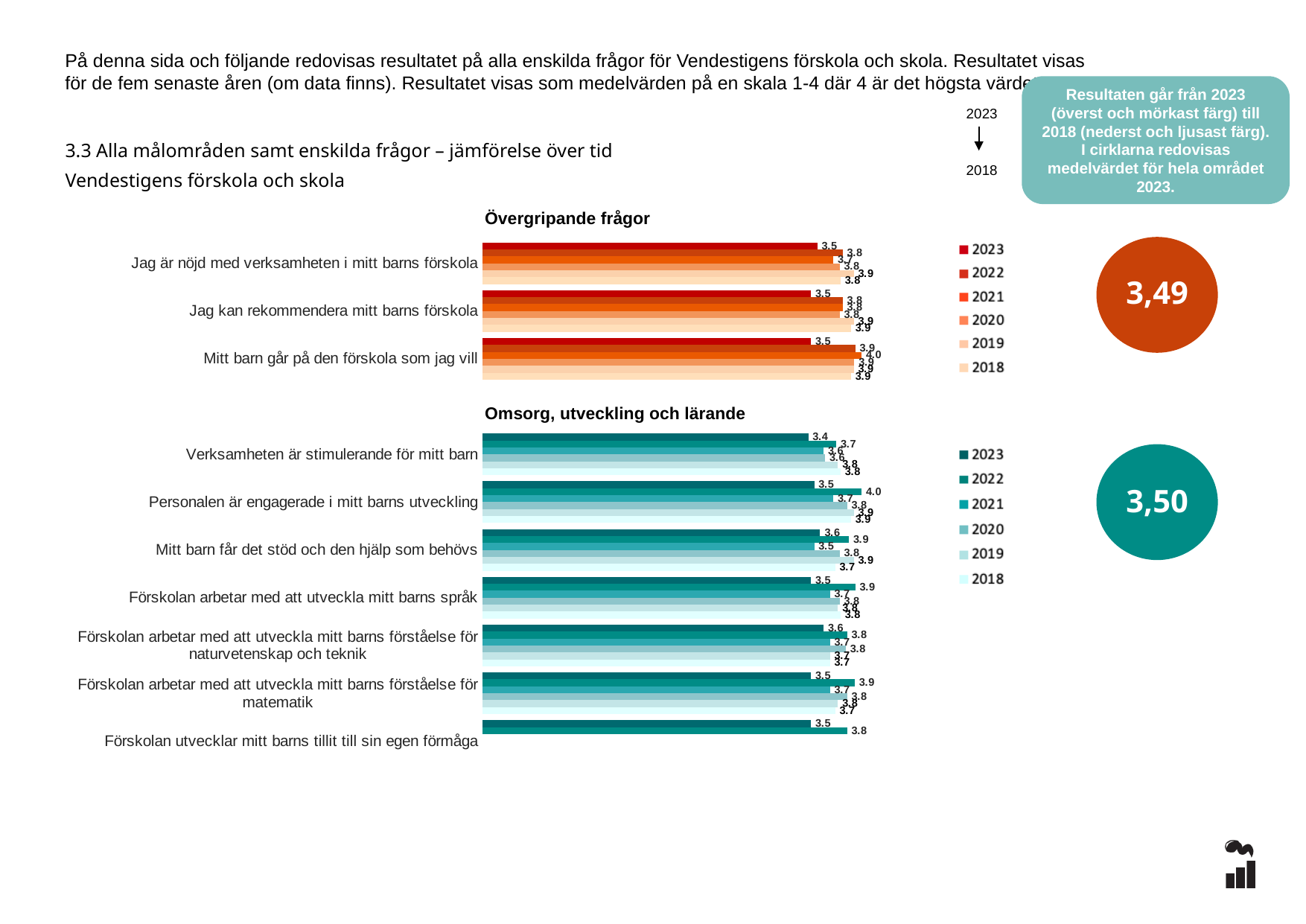
In the "Övergripande frågor" chart, what is the 2021 value for "Mitt barn går på den förskola som jag vill"? 4.0 How many series does the legend of the "Omsorg, utveckling och lärande" chart list? 6 How many questions (categories) are shown in the "Omsorg, utveckling och lärande" chart? 7 What overall 2023 mean value is shown in the circle next to the "Omsorg, utveckling och lärande" chart? 3,50 What overall 2023 mean value is shown in the circle next to the "Övergripande frågor" chart? 3,49 In the "Omsorg, utveckling och lärande" chart, which is larger for "Mitt barn får det stöd och den hjälp som behövs": the 2023 value or the 2022 value? 2022 In the "Omsorg, utveckling och lärande" chart, what is the difference between the 2022 and 2023 values for "Personalen är engagerade i mitt barns utveckling"? 0.5 In the "Omsorg, utveckling och lärande" chart, what is the 2023 value for "Verksamheten är stimulerande för mitt barn"? 3.4 What kind of chart is the "Omsorg, utveckling och lärande" chart? Bar chart In the "Omsorg, utveckling och lärande" chart, what is the 2022 value for "Personalen är engagerade i mitt barns utveckling"? 4.0 How many questions (categories) are shown in the "Övergripande frågor" chart? 3 In the "Övergripande frågor" chart, what is the 2023 value for "Jag är nöjd med verksamheten i mitt barns förskola"? 3.5